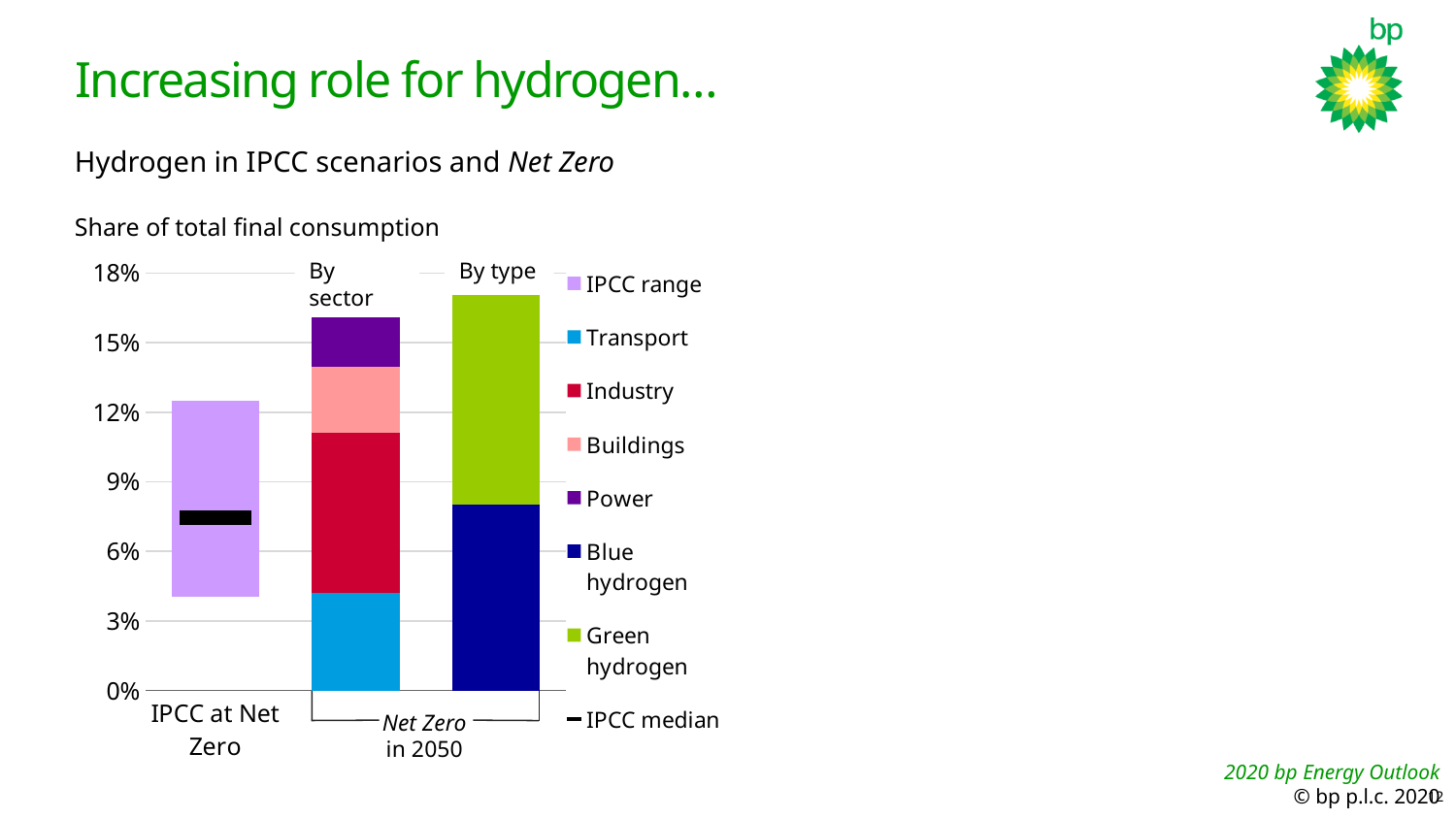
In the 'By sector' bar, which segment is larger: Transport or Power? Transport Is the Transport segment in the 'By sector' bar greater or less than 6%? less Is the bottom of the IPCC range bar greater or less than 6%? less Is the Blue hydrogen segment in the 'By type' bar greater or less than 6%? greater What kind of chart is shown on the slide? bar chart How many entries does the chart legend list? 8 What does the y-axis of the chart measure, according to the label above it? Share of total final consumption How many bars are plotted in the chart? 3 In the 'By sector' bar, which segment is larger: Industry or Buildings? Industry